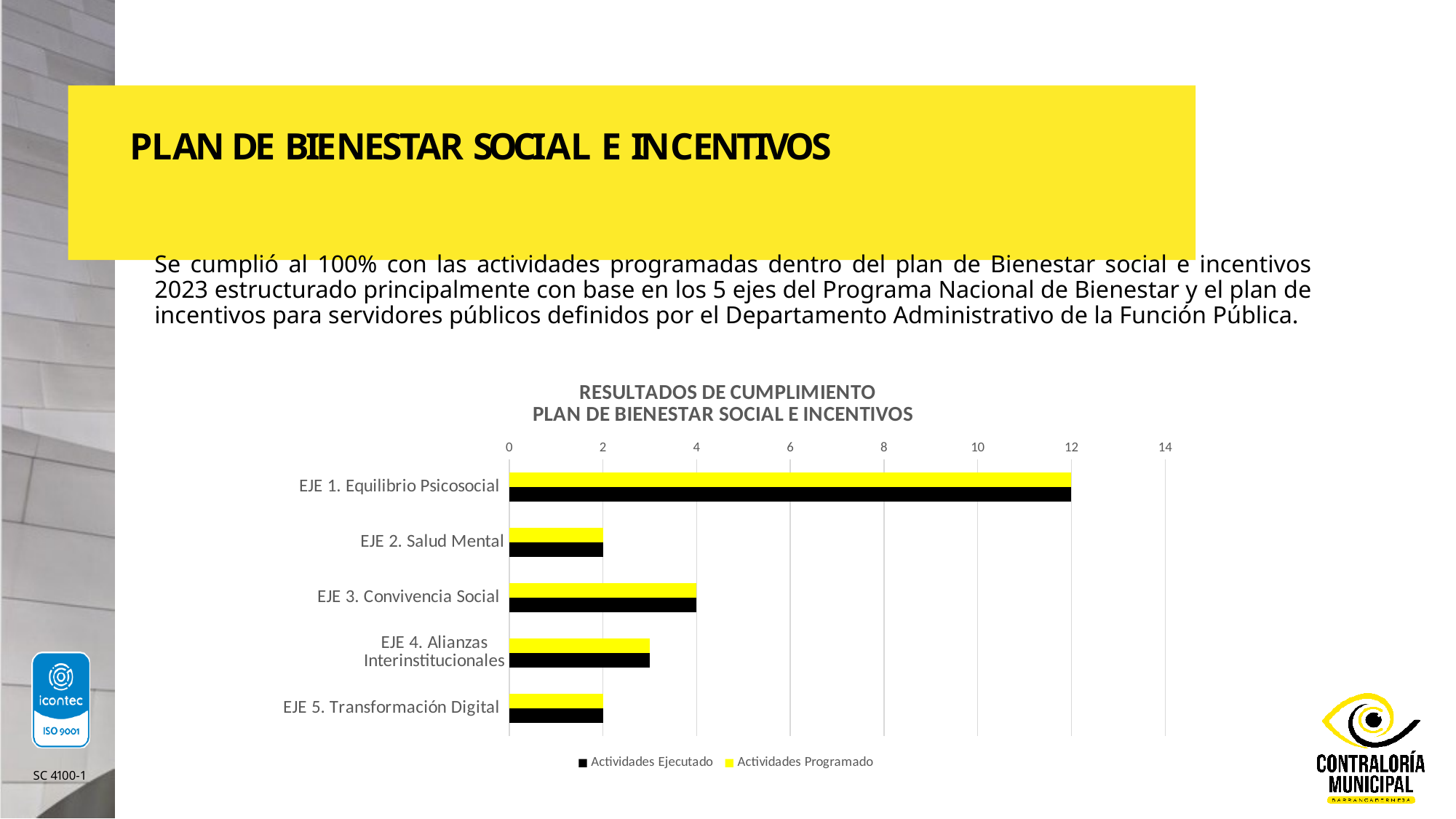
What is the value of Actividades Ejecutado for EJE 2. Salud Mental? 2 How many series does the legend list? 2 Which has a larger Actividades Programado value, EJE 3. Convivencia Social or EJE 2. Salud Mental? EJE 3. Convivencia Social What is the difference between the Actividades Ejecutado values for EJE 1. Equilibrio Psicosocial and EJE 3. Convivencia Social? 8 Which colour represents Actividades Programado in the chart? yellow What is the value of Actividades Ejecutado for EJE 1. Equilibrio Psicosocial? 12 What kind of chart is shown on the slide? bar chart How many categories (ejes) are plotted in the chart? 5 Is the Actividades Ejecutado value for EJE 4. Alianzas Interinstitucionales greater or less than 2? greater Which category has the highest value for Actividades Ejecutado? EJE 1. Equilibrio Psicosocial What is the value of Actividades Programado for EJE 5. Transformación Digital? 2 What is the value of Actividades Programado for EJE 3. Convivencia Social? 4